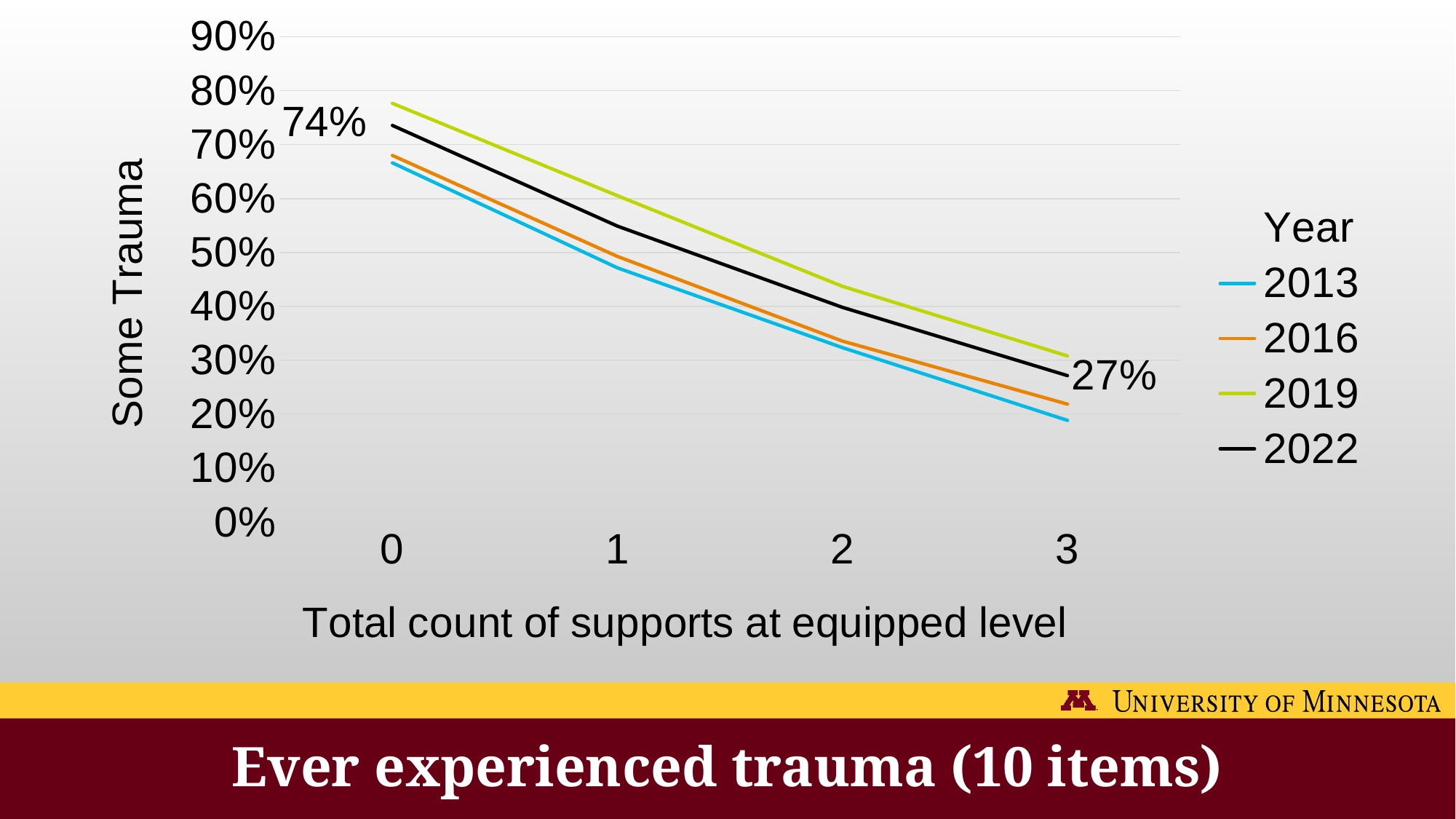
At 2 supports, which is larger: the value for 2019 or the value for 2013? 2019 What is the value for the 2022 series at 3 supports? 27% How many series does the legend list? 4 By how many percentage points does the 2022 series fall from 0 supports to 3 supports? 47 percentage points Which year has the lowest value at 3 supports? 2013 Which year has the highest value at 0 supports? 2019 Is the value for 2016 at 3 supports greater or less than 30%? less How many points are on the x axis? 4 What is the title of the y axis? Some Trauma What kind of chart is shown? Line chart What is the value for the 2022 series at 0 supports? 74% Do the values rise or fall as the total count of supports increases? Fall